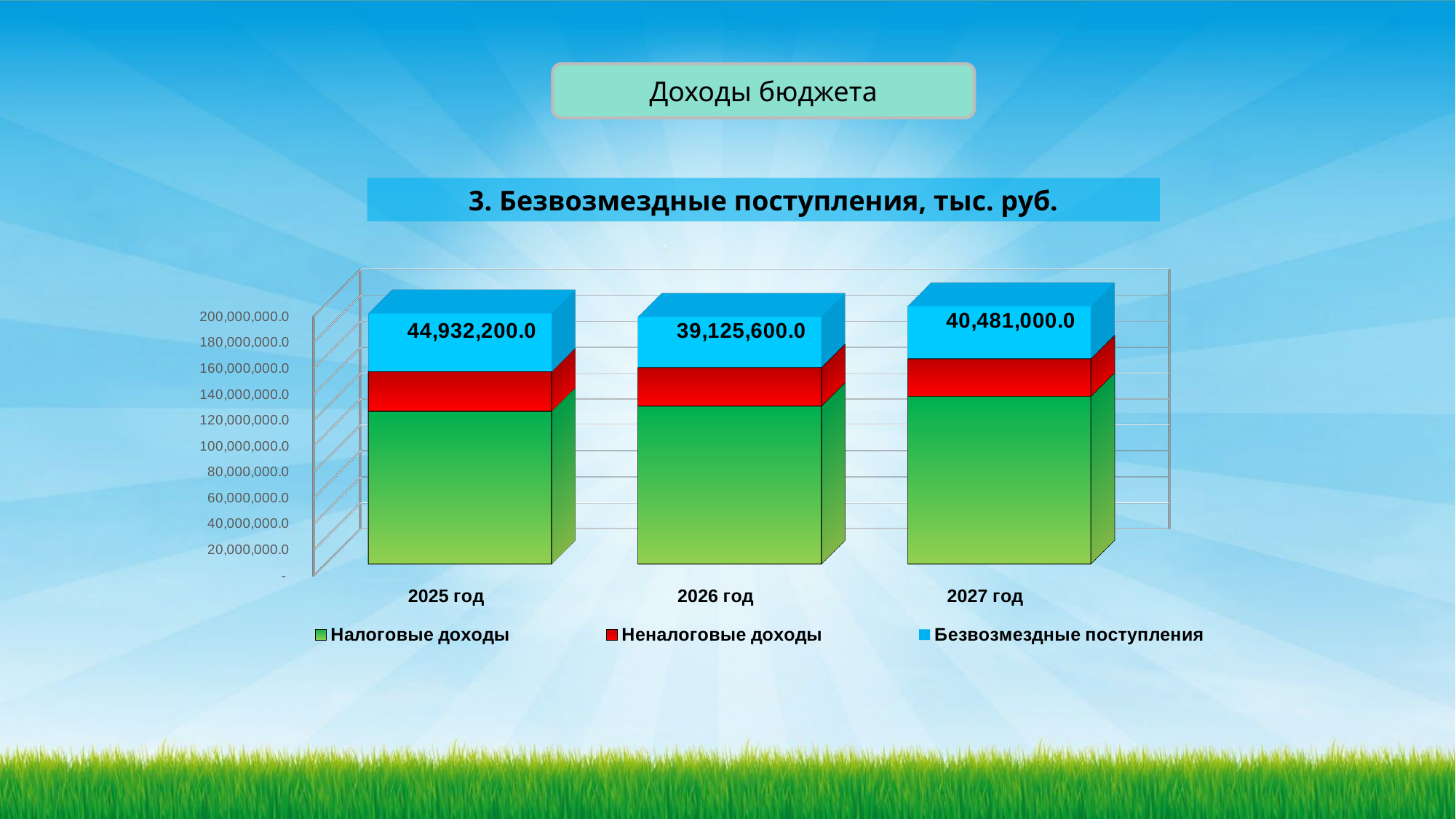
Which colour represents Неналоговые доходы in the chart? Red Is the Безвозмездные поступления value larger for 2025 год or for 2027 год? 2025 год What is the value of Безвозмездные поступления for 2025 год? 44,932,200.0 What is the value of Безвозмездные поступления for 2027 год? 40,481,000.0 What is the difference between the Безвозмездные поступления values for 2025 год and 2026 год? 5,806,600.0 What type of chart is shown on the slide? Stacked bar chart What is the value of Безвозмездные поступления for 2026 год? 39,125,600.0 What is the difference between the Безвозмездные поступления values for 2027 год and 2026 год? 1,355,400.0 How many series does the chart legend list? 3 How many years are shown on the x axis of the chart? 3 Which year has the highest labelled value for Безвозмездные поступления? 2025 год Which year has the lowest labelled value for Безвозмездные поступления? 2026 год